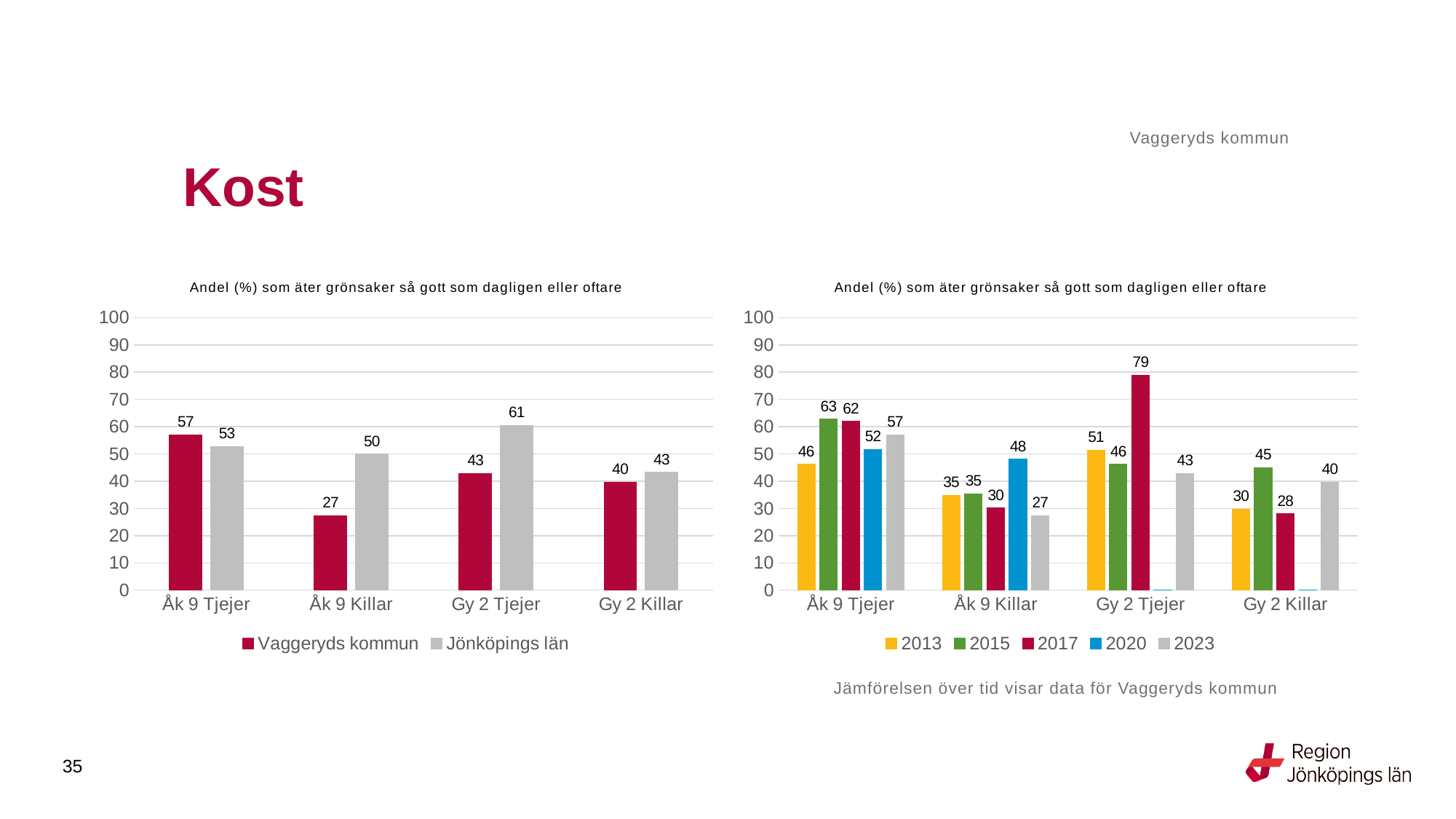
In the right chart, what is the value for 2017 for Gy 2 Tjejer? 79 In the right chart, what is the value for 2020 for Åk 9 Killar? 48 In the left chart, what is the value for Vaggeryds kommun for Åk 9 Tjejer? 57 In the right chart, which year has the highest value for Åk 9 Tjejer? 2015 How many series does the legend of the right chart list? 5 In the right chart, what is the difference between the 2015 and 2017 values for Gy 2 Killar? 17 In the left chart, which category has the lowest value for Vaggeryds kommun? Åk 9 Killar In the left chart, what is the difference between Jönköpings län and Vaggeryds kommun for Åk 9 Killar? 23 What kind of chart is the right chart? Bar chart In the left chart, which is larger for Gy 2 Killar: Vaggeryds kommun or Jönköpings län? Jönköpings län In the left chart, what is the value for Jönköpings län for Gy 2 Tjejer? 61 How many series does the legend of the left chart list? 2